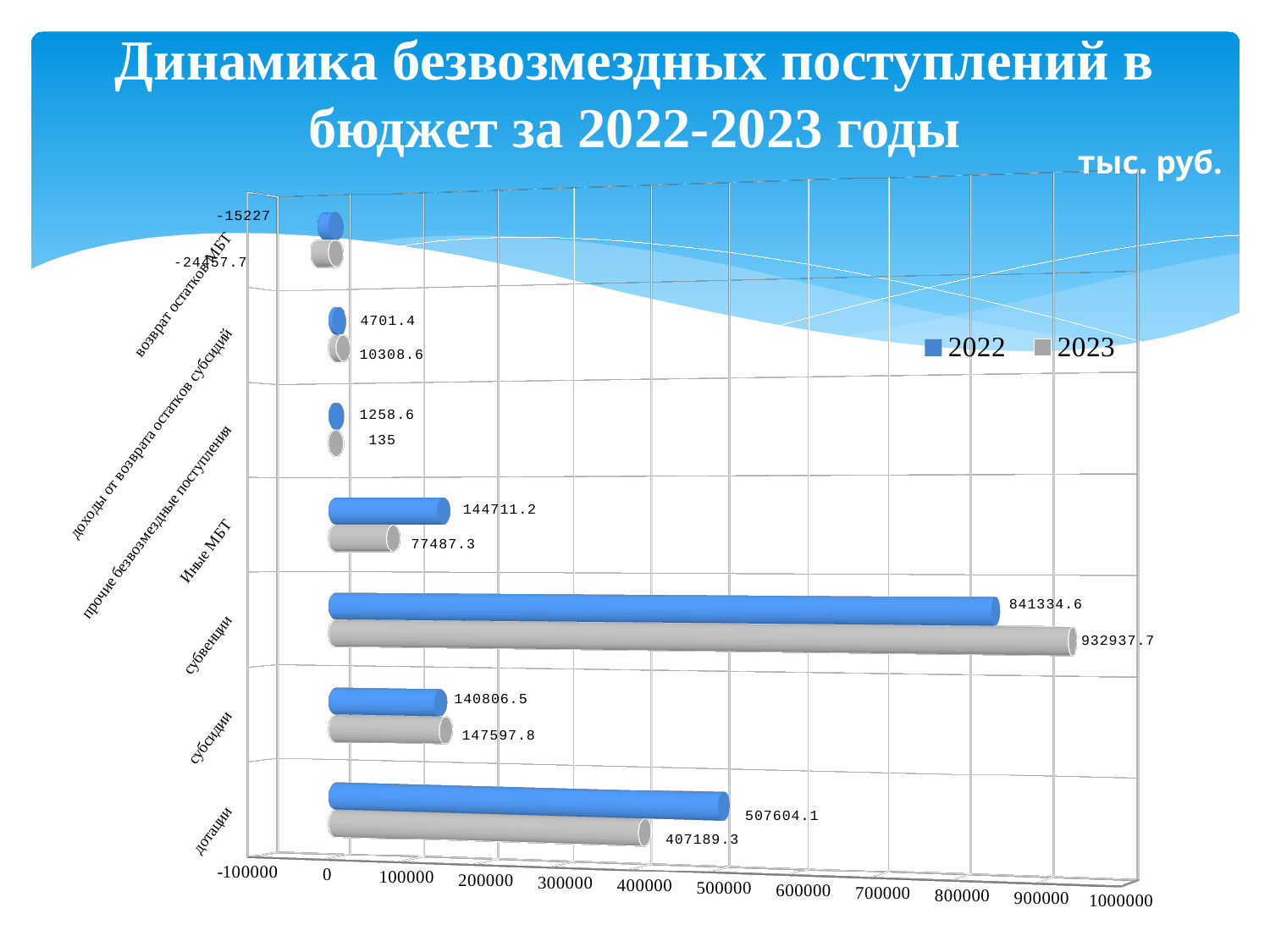
What is the 2023 value for дотации? 407189.3 What is the 2022 value for доходы от возврата остатков субсидий? 4701.4 What is the 2023 value for Иные МБТ? 77487.3 Which category has the highest 2023 value? субвенции What is the difference between the 2022 and 2023 values for дотации? 100414.8 How many series does the legend list? 2 For субсидии, which year has the larger value, 2022 or 2023? 2023 What is the difference between the 2023 and 2022 values for субвенции? 91603.1 How many categories are shown on the chart? 7 What is the 2022 value for субвенции? 841334.6 What type of chart is shown on the slide? bar chart Which category has the lowest 2022 value? возврат остатков МБТ